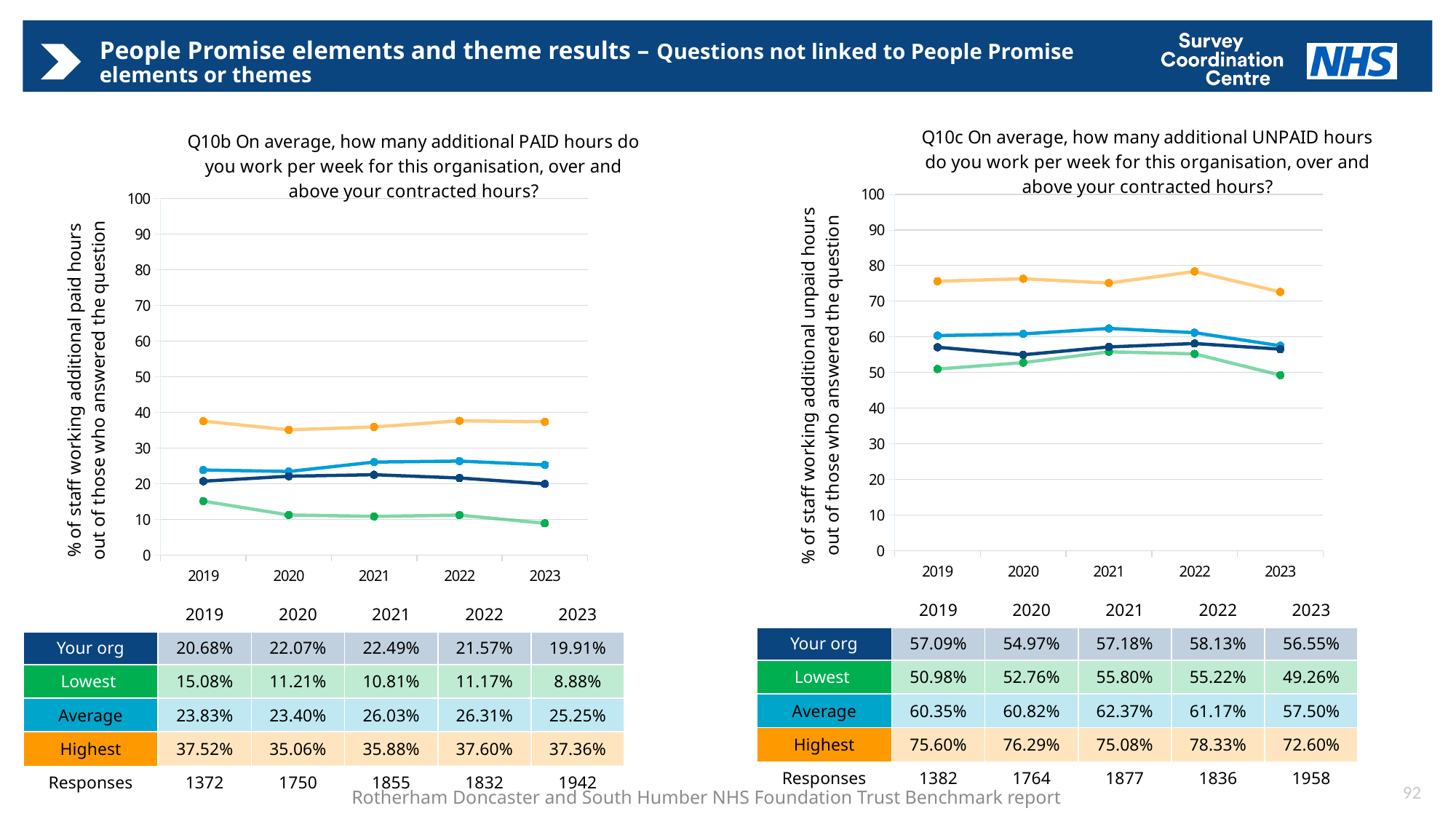
In the Q10b (PAID hours) chart, what is the value for Your org in 2021? 22.49% In the Q10c (UNPAID hours) chart, is the Highest value for 2019 greater or less than 70? greater In the Q10c (UNPAID hours) chart, in which year is the Lowest series at its lowest value? 2023 In the Q10b (PAID hours) chart, does the Lowest series rise or fall from 2019 to 2023? Fall What type of chart is used for Q10b (additional PAID hours)? Line chart How many years are plotted on the x axis of the Q10b (PAID hours) chart? 5 In the Q10c (UNPAID hours) chart, what is the Highest value in 2022? 78.33% In the Q10c (UNPAID hours) chart, what is the difference between the Highest and Lowest values in 2022? 23.11 percentage points In the Q10c (UNPAID hours) chart, is the Your org value higher in 2021 or 2022? 2022 How many series are shown in the Q10c (UNPAID hours) chart? 4 In the Q10b (PAID hours) chart, which year has the highest value for the Highest series? 2022 In the Q10b (PAID hours) chart, what is the difference between the Average and Your org values in 2023? 5.34 percentage points